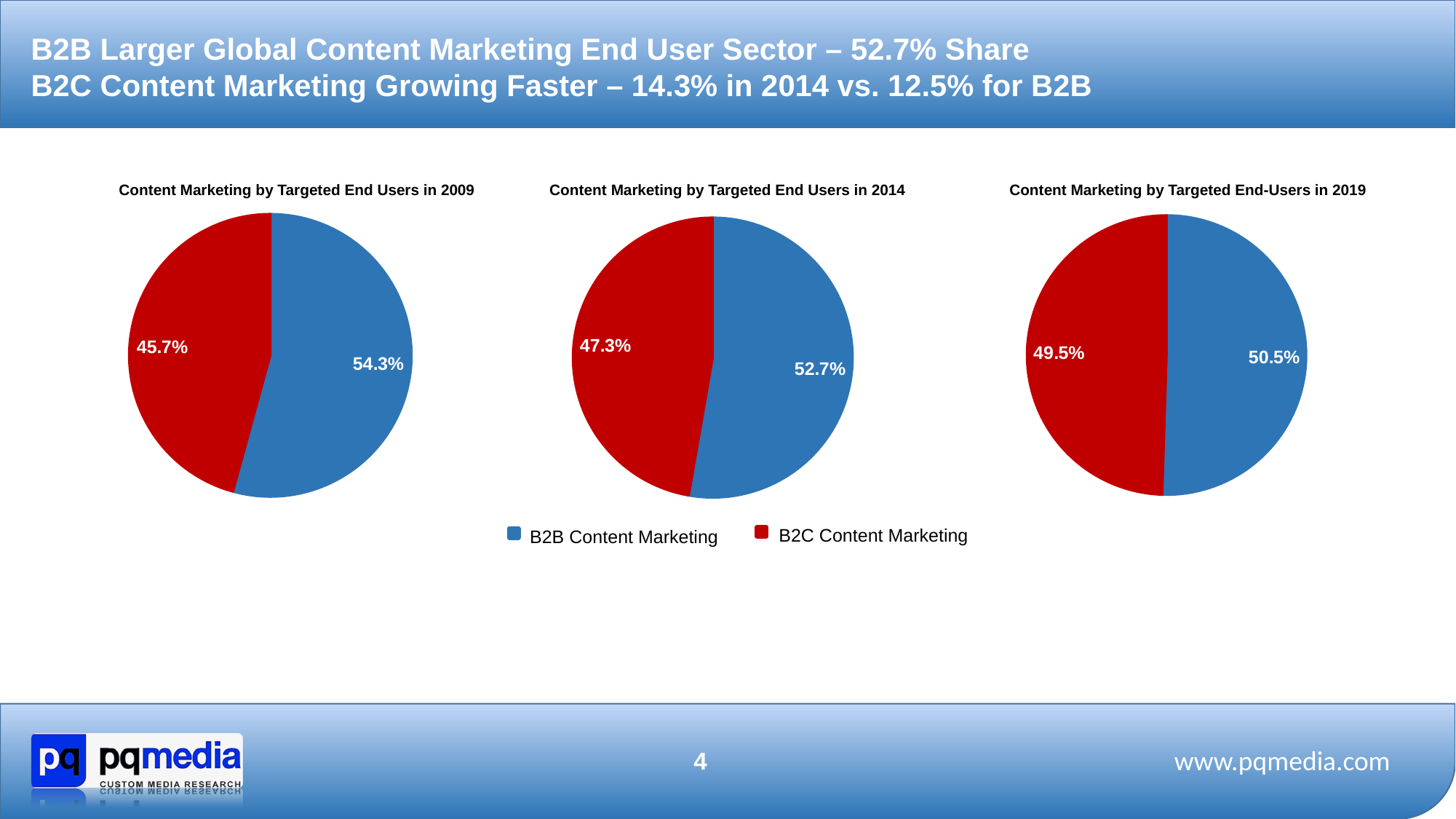
In the 'Content Marketing by Targeted End Users in 2014' chart, what share does B2B Content Marketing have? 52.7% How many pie charts are shown on the slide? 3 In the 'Content Marketing by Targeted End Users in 2009' chart, what share does B2B Content Marketing have? 54.3% How many entries does the legend list? 2 In the 'Content Marketing by Targeted End Users in 2009' chart, which slice is larger, B2B Content Marketing or B2C Content Marketing? B2B Content Marketing In the 'Content Marketing by Targeted End Users in 2014' chart, what share does B2C Content Marketing have? 47.3% In the 'Content Marketing by Targeted End Users in 2009' chart, what is the difference between the B2B and B2C shares? 8.6% What kind of chart is used on this slide? Pie chart In the 'Content Marketing by Targeted End-Users in 2019' chart, what share does B2B Content Marketing have? 50.5% In the 'Content Marketing by Targeted End Users in 2014' chart, what is the difference between the B2B and B2C shares? 5.4% In the 'Content Marketing by Targeted End-Users in 2019' chart, what share does B2C Content Marketing have? 49.5% In the 'Content Marketing by Targeted End Users in 2009' chart, what share does B2C Content Marketing have? 45.7%